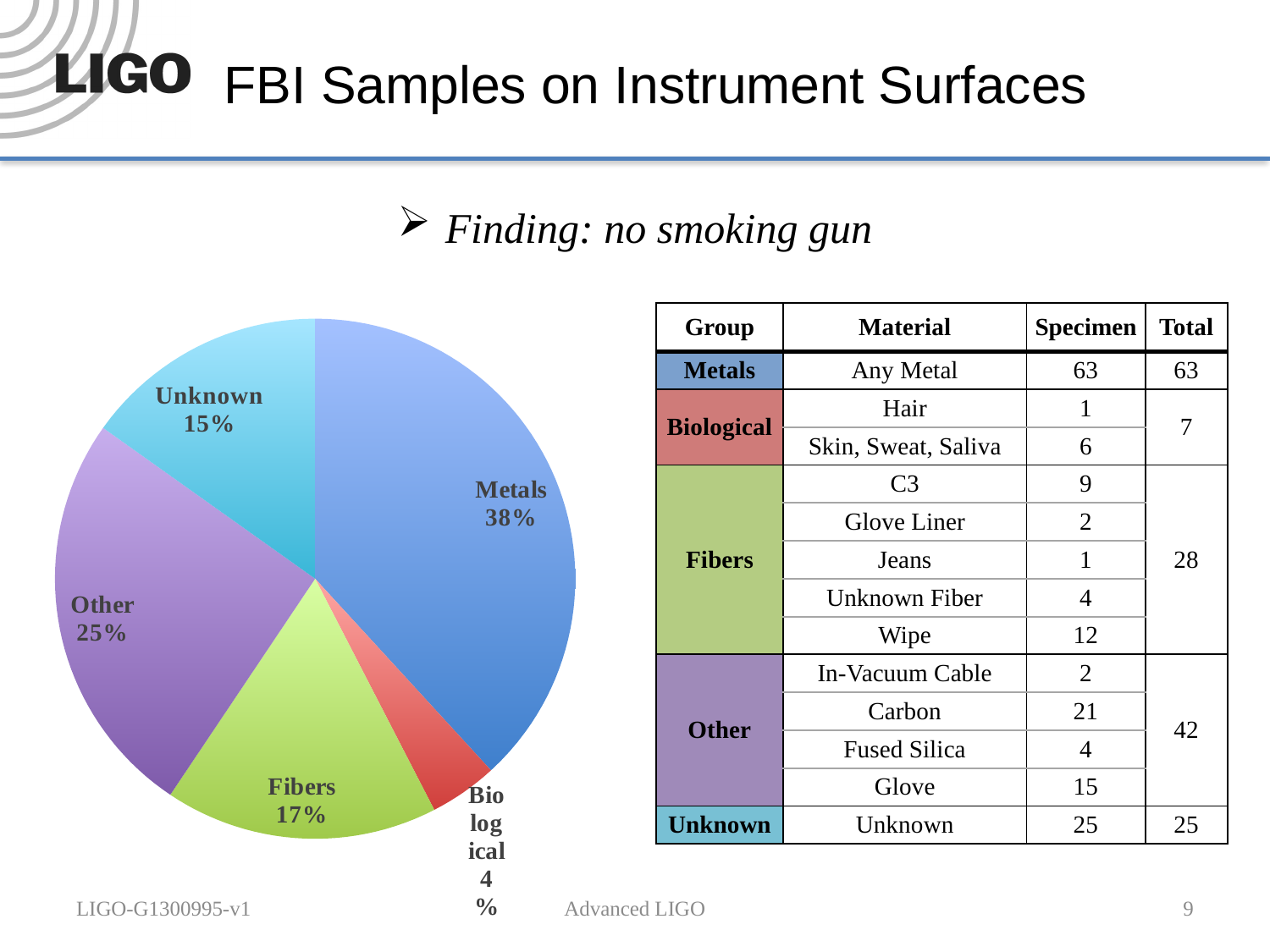
What share of the pie chart is Other? 25% How many slices does the pie chart have? 5 What share of the pie chart is Unknown? 15% In the pie chart, what is the difference in percentage points between Metals and Unknown? 23 Which slice of the pie chart is the smallest? Biological What share of the pie chart is Fibers? 17% In the pie chart, which is larger, Other or Fibers? Other What kind of chart is shown on the slide? pie chart Which slice of the pie chart is coloured green? Fibers Which slice of the pie chart is the largest? Metals